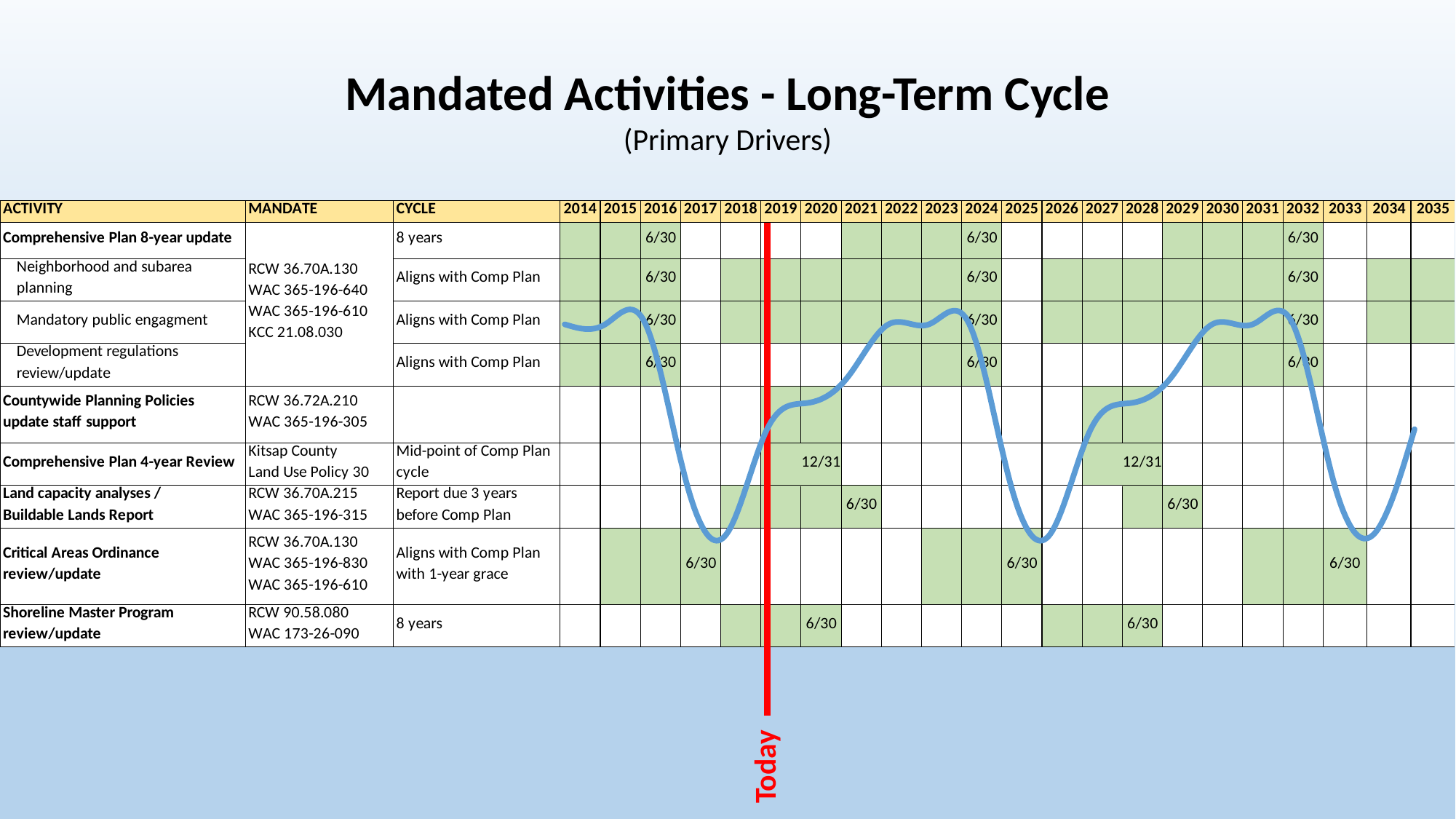
In the Mandated Activities timeline, what deadline date is shown for the Comprehensive Plan 4-year Review? 12/31 What are the first and last years shown on the Mandated Activities timeline? 2014 and 2035 What does the red vertical line on the Mandated Activities timeline mark? Today In the Mandated Activities timeline, in which years does the Shoreline Master Program review/update show a 6/30 deadline? 2020, 2028 How many year columns does the Mandated Activities timeline span? 22 In the Mandated Activities timeline, in which years does the Critical Areas Ordinance review/update show a 6/30 deadline? 2017, 2025, 2033 In the Mandated Activities timeline, in which years does the Land capacity analyses / Buildable Lands Report show a 6/30 deadline? 2021, 2029 In the Mandated Activities timeline, in which years does the Comprehensive Plan 4-year Review show a 12/31 deadline? 2020, 2028 What is the cycle listed for the Critical Areas Ordinance review/update in the Mandated Activities timeline? Aligns with Comp Plan with 1-year grace In the Mandated Activities timeline, in which year is the first 6/30 deadline shown for the Comprehensive Plan 8-year update? 2016 In the Mandated Activities timeline, in which years are 6/30 deadlines shown for the Comprehensive Plan 8-year update? 2016, 2024, 2032 In the Mandated Activities timeline, what is the cycle listed for the Comprehensive Plan 8-year update? 8 years